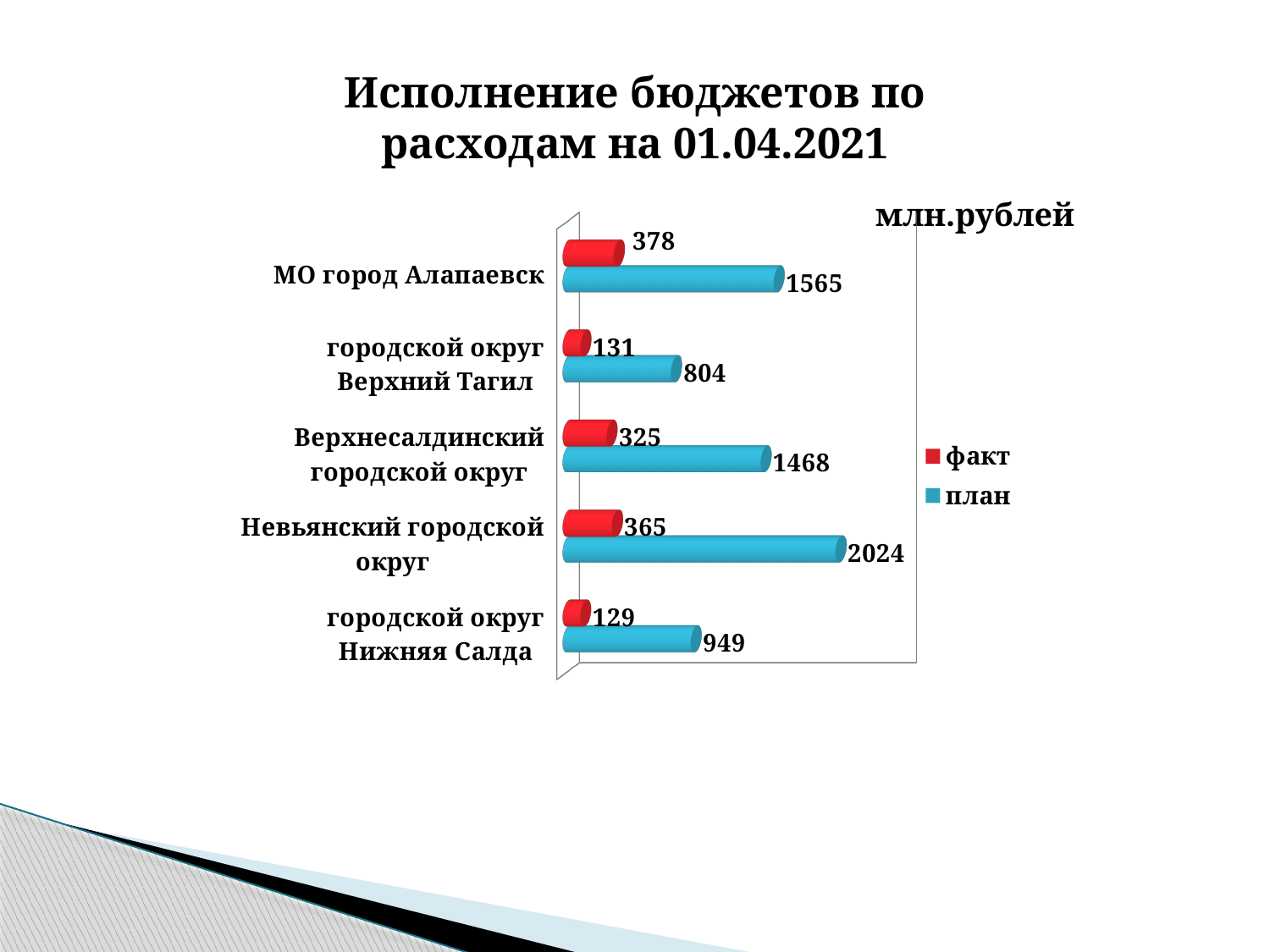
How many categories are shown on the chart? 5 How many series does the legend list? 2 What is the факт value for Невьянский городской округ? 365 What unit is indicated for the values on the chart? млн.рублей What is the план value for МО город Алапаевск? 1565 Which category has the highest план value? Невьянский городской округ Which category has the lowest факт value? городской округ Нижняя Салда What kind of chart is shown on the slide? bar chart What is the difference between the план and факт values for Верхнесалдинский городской округ? 1143 Which colour represents the факт series? red Which is larger: the факт value for МО город Алапаевск or the факт value for городской округ Верхний Тагил? МО город Алапаевск What is the план value for городской округ Нижняя Салда? 949